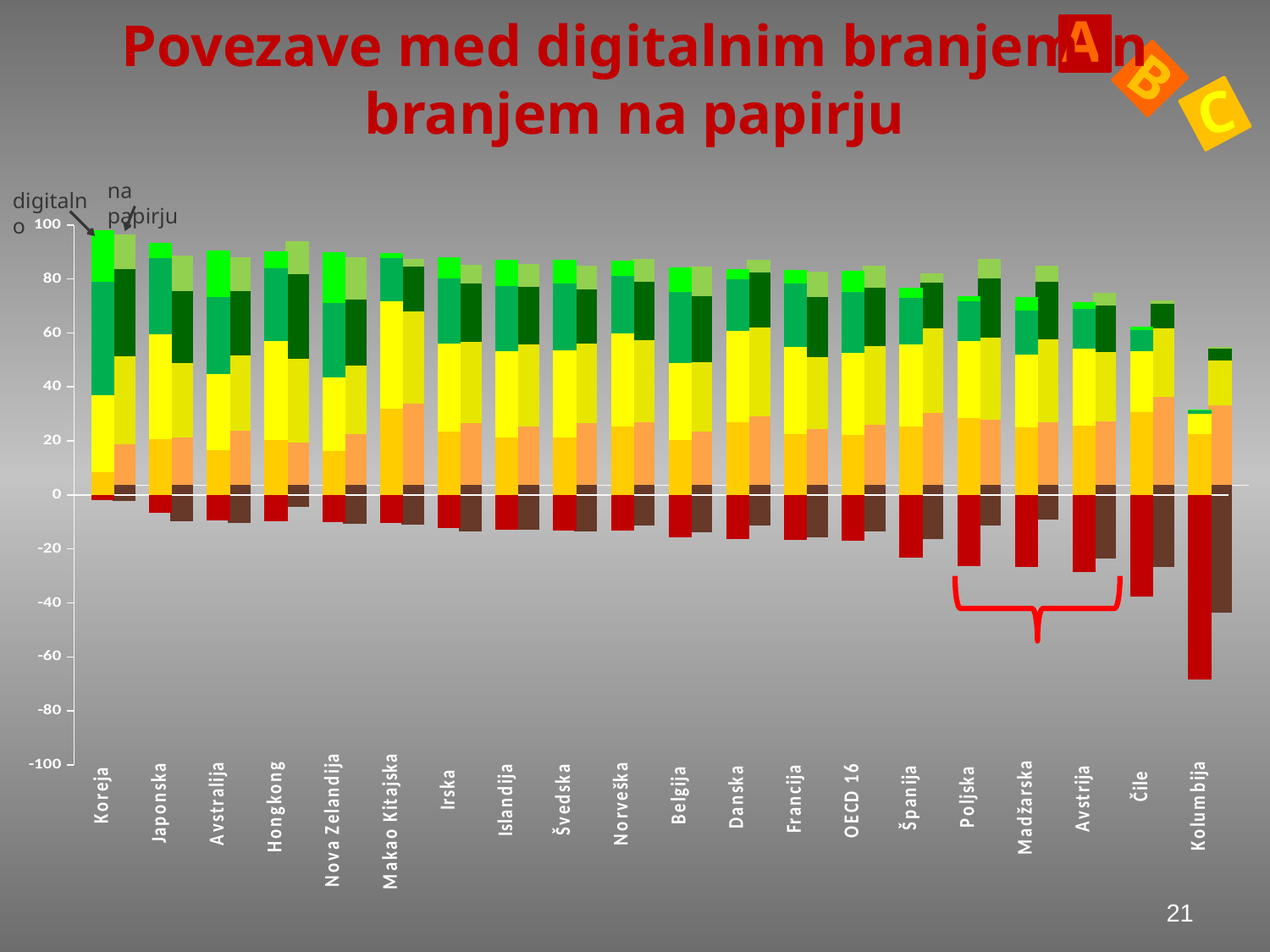
Is the bottom of the red digital bar for Čile greater or less than -20? less Is the top of the digital stacked bar for Kolumbija greater or less than 40? less Is the top of the digital stacked bar for Koreja greater or less than 80? greater What is the highest value shown on the vertical axis of the chart? 100 Which country has the longest negative (red) bar for digital reading? Kolumbija Which category is listed last on the x axis of the chart? Kolumbija Which category is listed first on the x axis of the chart? Koreja Do the negative (red) digital bars generally get longer or shorter moving from left to right along the x axis? longer What kind of chart is shown on the slide? Stacked bar chart How many countries or groups are listed along the x axis of the chart? 20 Which has a taller positive digital stacked bar, Koreja or Kolumbija? Koreja